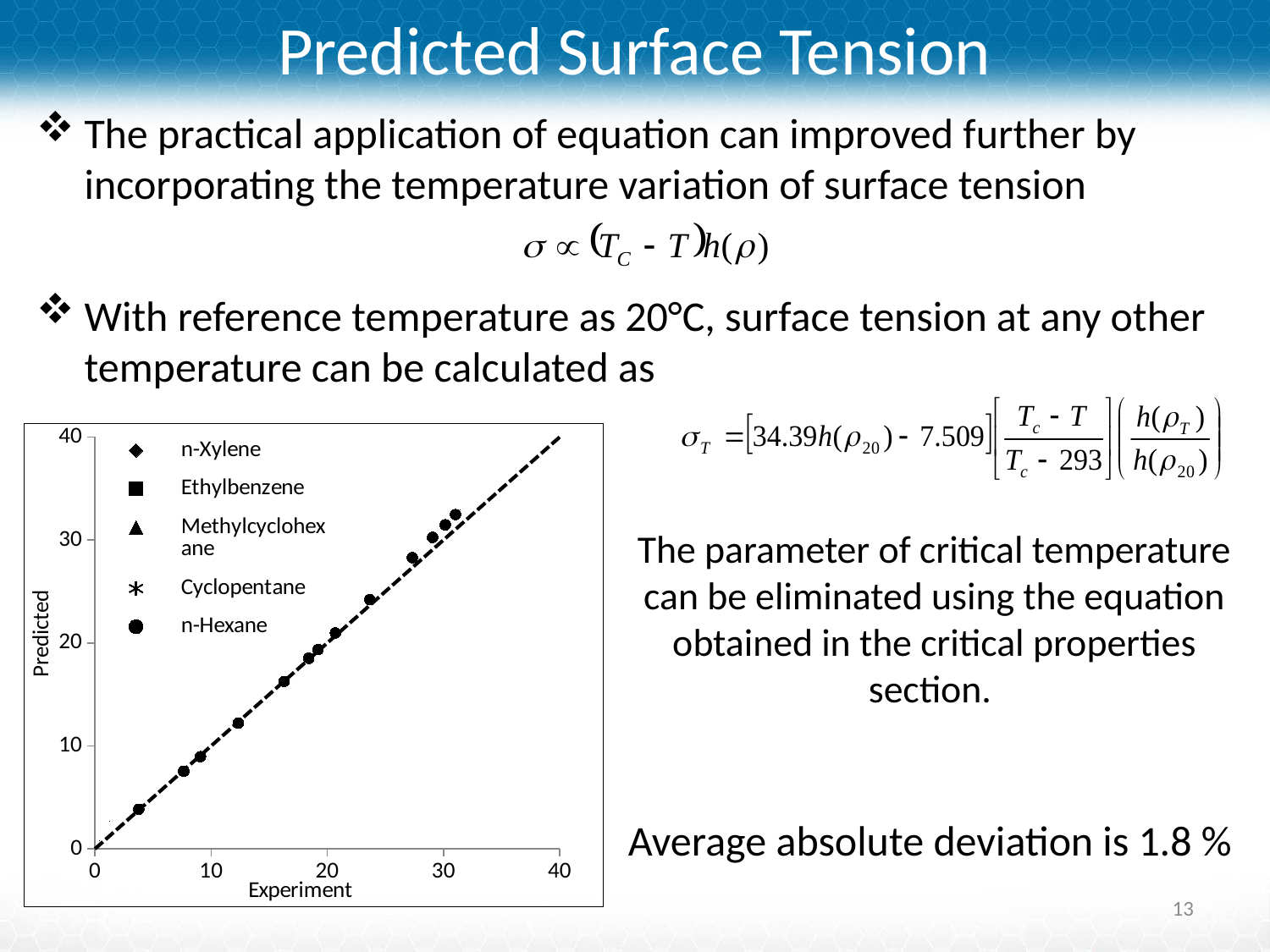
Is the highest plotted Predicted value greater or less than 30? greater What kind of chart is shown on the slide? Scatter chart What are the titles of the x axis and y axis of the chart? Experiment (x axis) and Predicted (y axis) How many series does the chart's legend list? 5 Which series are listed in the chart's legend? n-Xylene, Ethylbenzene, Methylcyclohexane, Cyclopentane, n-Hexane Do the plotted Predicted values rise or fall as the Experiment value increases? Rise Is the lowest plotted Experiment value greater or less than 10? less